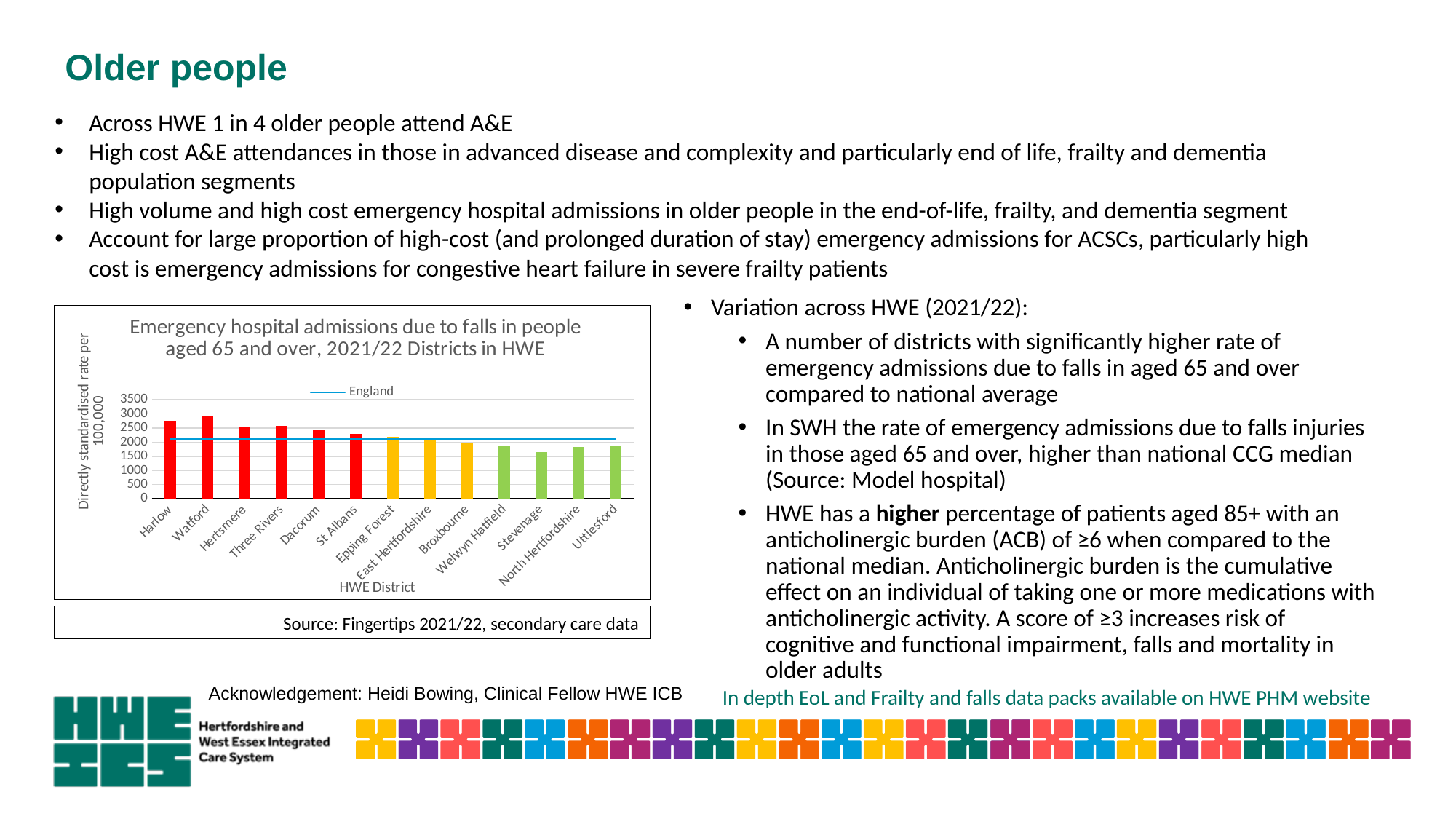
Which district has the lowest emergency hospital admission rate due to falls in the chart? Stevenage What is the only entry listed in the chart's legend? England Is the value for Welwyn Hatfield greater or less than 2000? less Is the value for Harlow greater or less than 2500? greater Which has the larger value, Harlow or Stevenage? Harlow Is the value for Stevenage greater or less than 2000? less Which district has the highest emergency hospital admission rate due to falls in the chart? Watford How many HWE districts are shown on the x axis of the chart? 13 What is the x-axis title of the chart? HWE District Do the bar values generally rise or fall moving from left to right along the x axis? fall What kind of chart is shown on the slide? combination bar and line chart